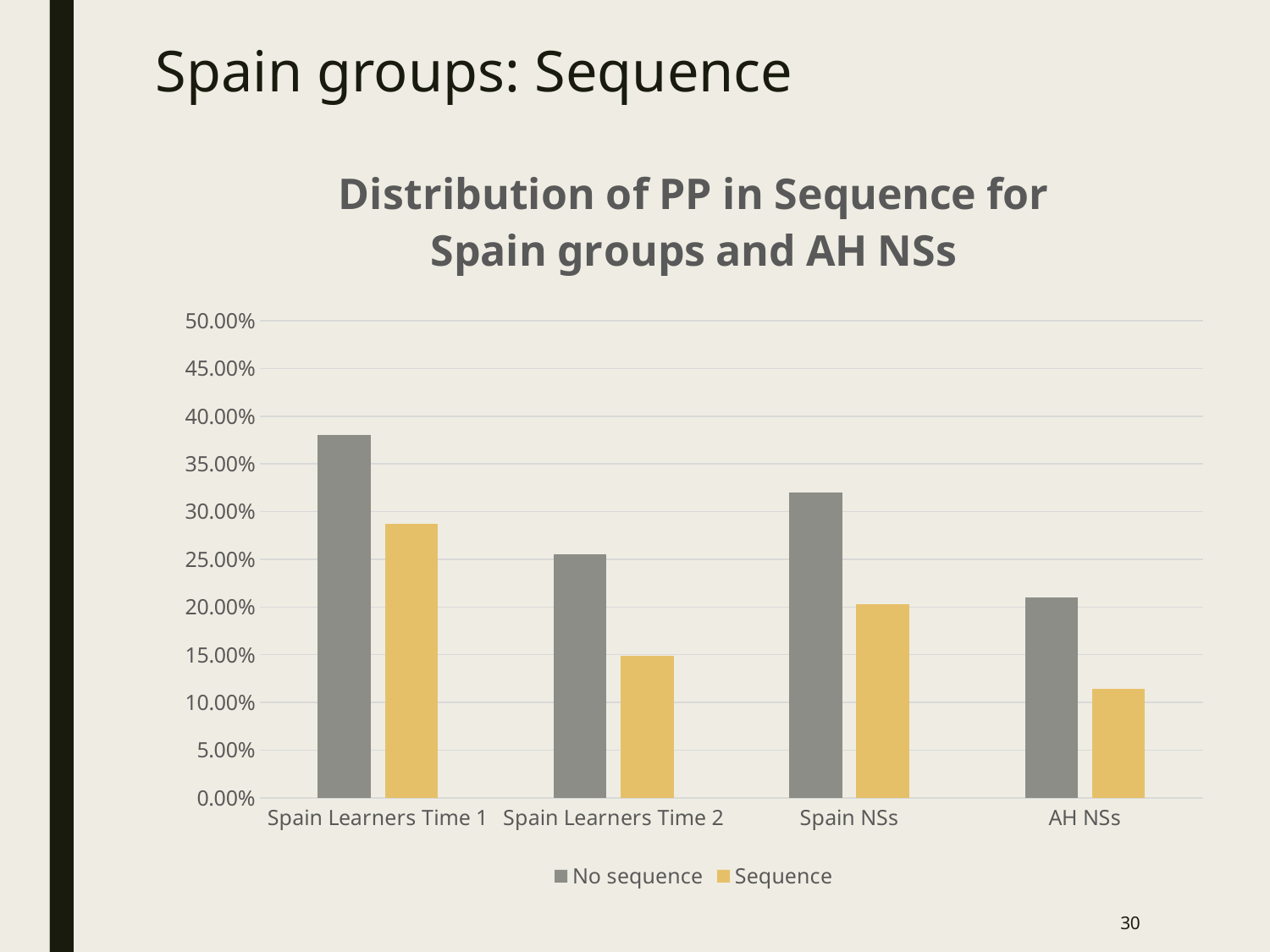
Is the 'Sequence' value for AH NSs greater or less than 15.00%? less Which group has the lowest 'Sequence' value? AH NSs How many series does the chart's legend list? 2 Which group has the highest 'No sequence' value? Spain Learners Time 1 What kind of chart is shown on the slide? Bar chart For Spain NSs, which series has the larger value, 'No sequence' or 'Sequence'? No sequence Which group has the lowest 'No sequence' value? AH NSs Is the 'No sequence' value for Spain Learners Time 1 greater or less than 35.00%? greater How many groups are shown along the x axis of the chart? 4 What is the title of the chart? Distribution of PP in Sequence for Spain groups and AH NSs Which is larger: the 'No sequence' value for Spain Learners Time 2 or the 'No sequence' value for Spain NSs? Spain NSs Is the 'No sequence' value for Spain NSs greater or less than 30.00%? greater